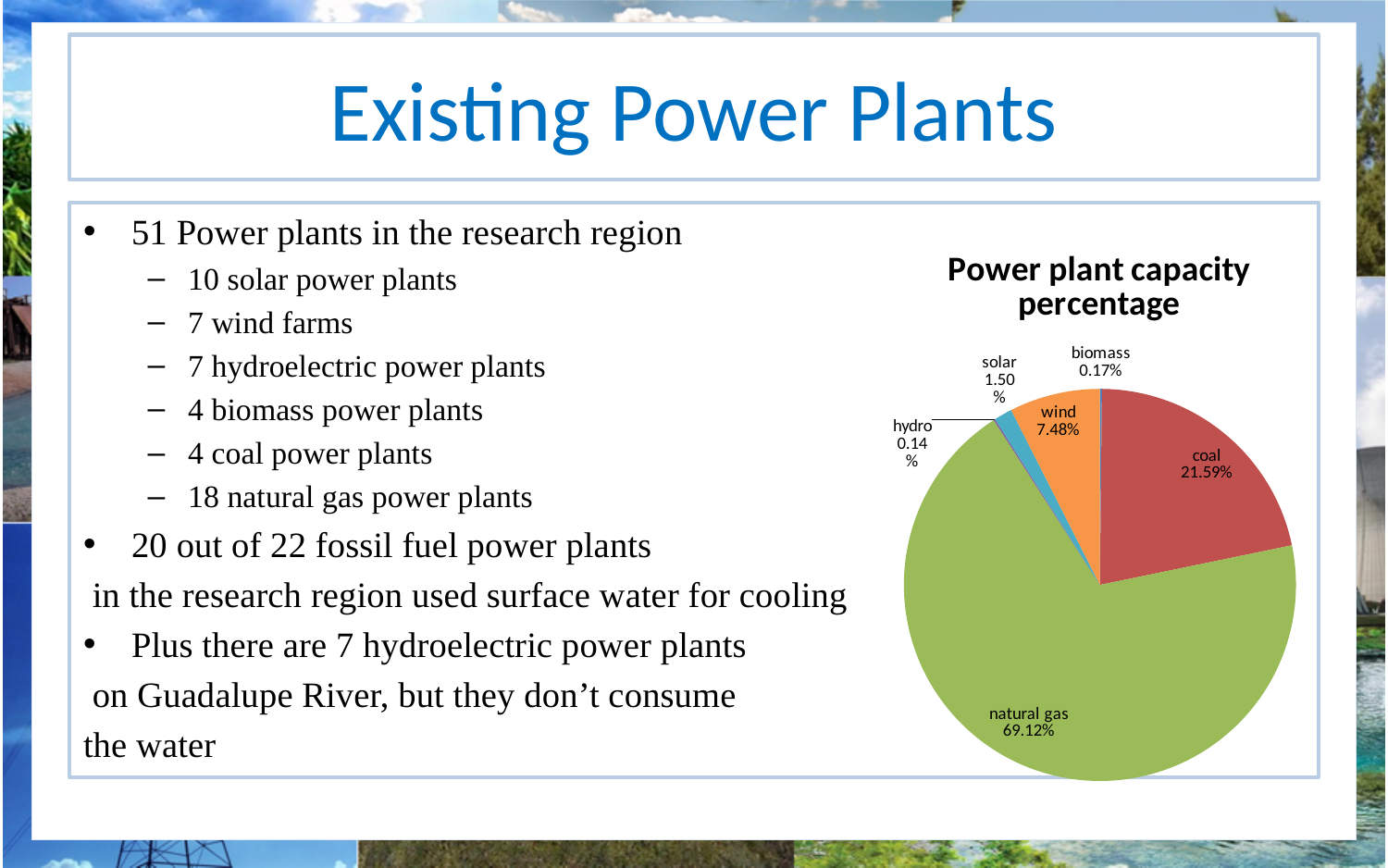
What percentage of power plant capacity does natural gas account for? 69.12% Which category has the smallest share of power plant capacity? hydro How many categories are shown in the pie chart? 6 What kind of chart is shown on the slide? pie chart What is the difference in capacity percentage between natural gas and coal? 47.53% What is the capacity percentage shown for biomass? 0.17% Which has a larger capacity percentage, wind or solar? wind What is the capacity percentage shown for coal? 21.59% What is the capacity percentage shown for wind? 7.48% What is the capacity percentage shown for solar? 1.50% Which category has the largest share of power plant capacity? natural gas What is the title of the chart? Power plant capacity percentage